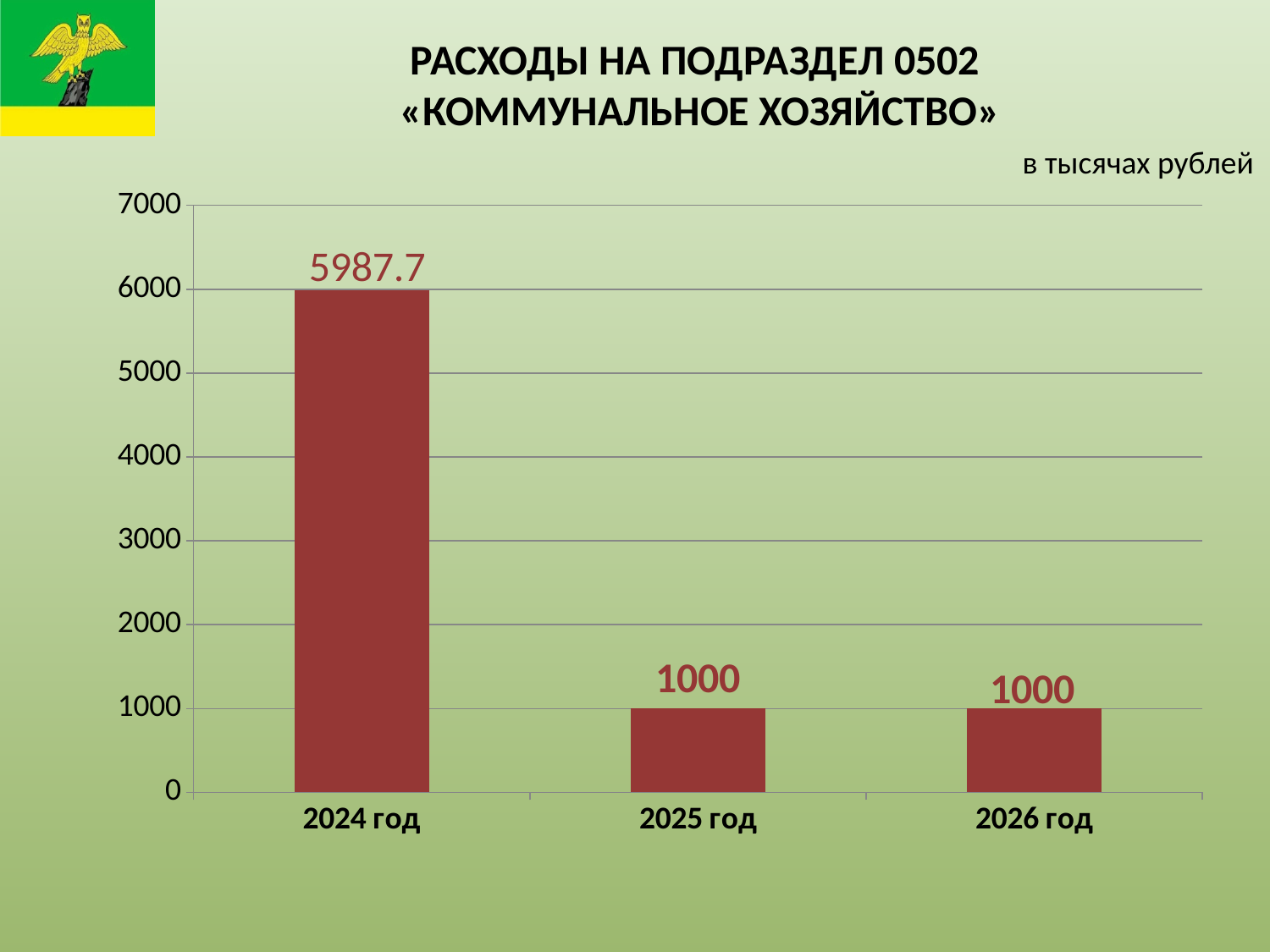
How many categories are shown on the x axis? 3 What is the difference between the values for 2024 год and 2025 год? 4987.7 Which year has the highest value? 2024 год What kind of chart is shown on the slide? bar chart Is the value for 2025 год greater or less than 2000? less Is the value for 2024 год greater or less than 5000? greater Which is larger, the value for 2024 год or the value for 2026 год? 2024 год In what units are the values given, according to the note above the chart? в тысячах рублей What is the value for 2026 год? 1000 Do the values rise or fall from 2024 год to 2025 год? fall What is the value for 2025 год? 1000 What is the value for 2024 год? 5987.7